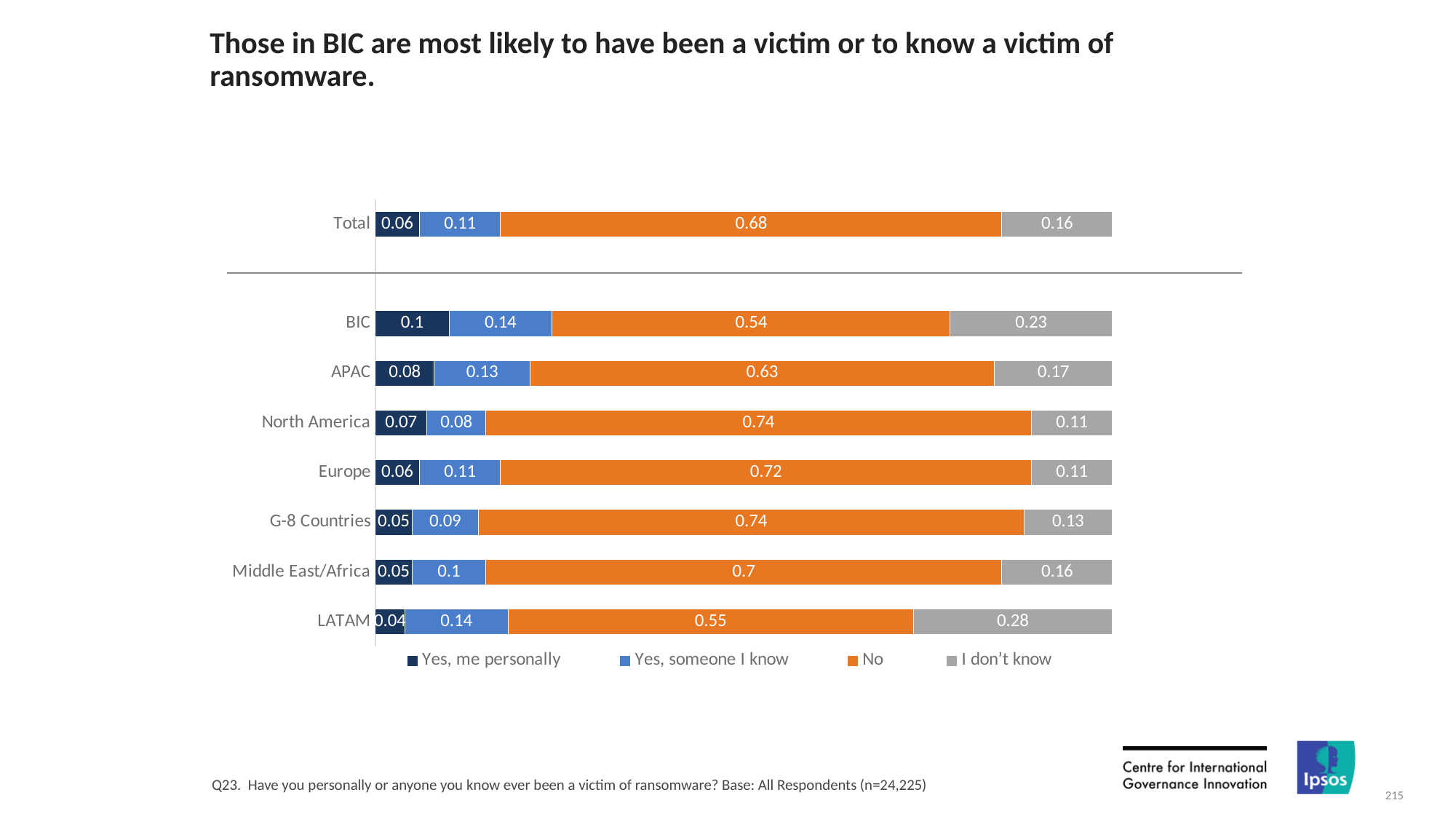
What is the value for "Yes, someone I know" in the APAC bar? 0.13 What is the difference between the "I don't know" values for LATAM and Total? 0.12 Which category has the lowest value for "No"? BIC What is the value for "Yes, me personally" in the Total bar? 0.06 Which region has the highest value for "Yes, me personally"? BIC What is the value for "I don't know" in the LATAM bar? 0.28 How many series does the legend list? 4 What is the value for "No" in the BIC bar? 0.54 How many categories (bars) are shown in the chart? 8 What kind of chart is shown on the slide? Stacked bar chart Which category has the highest value for "I don't know"? LATAM Which is larger: the "No" value for Europe or the "No" value for APAC? Europe